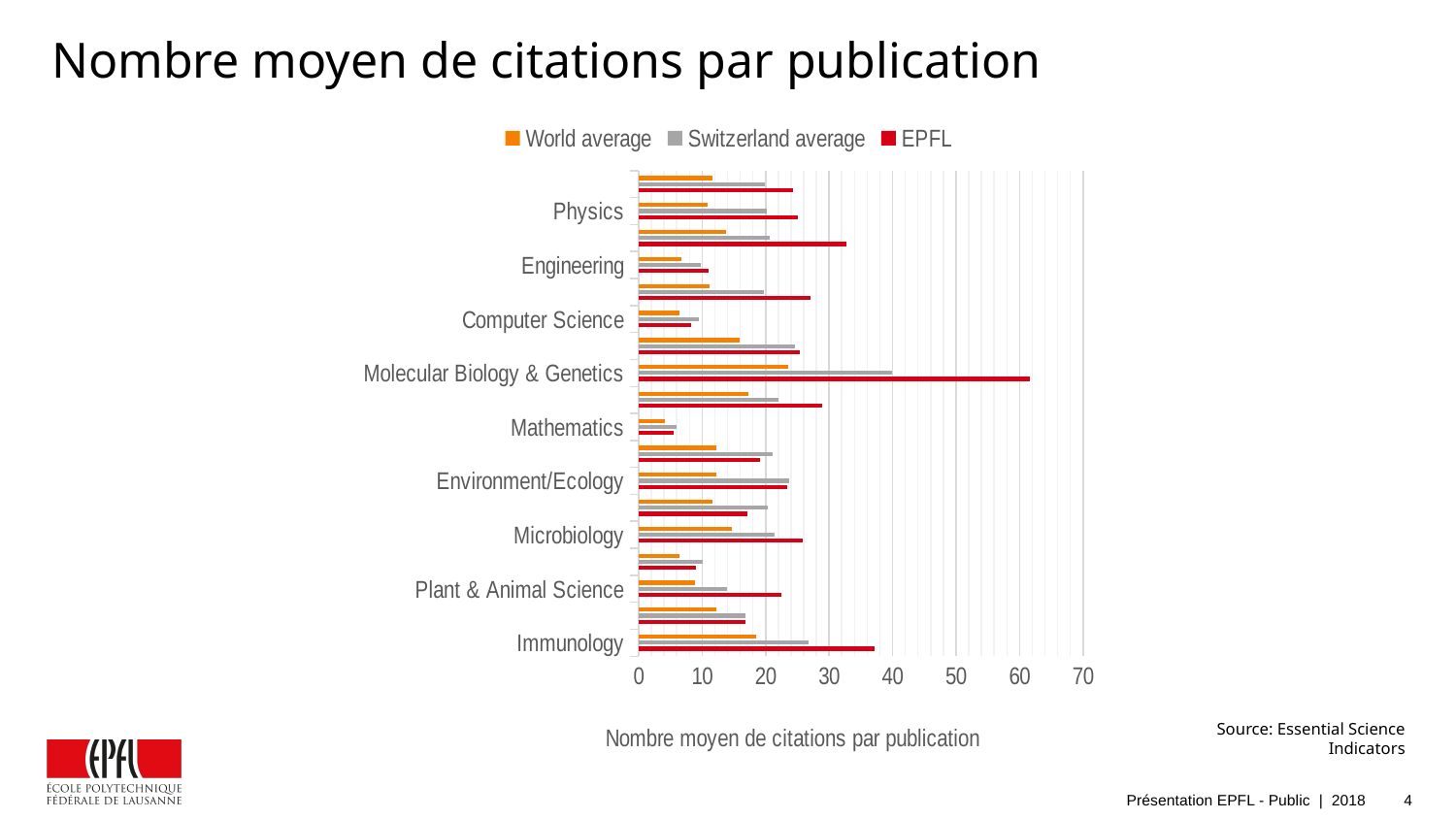
What kind of chart is shown on the slide? Bar chart For Immunology, which is larger: the EPFL value or the World average? EPFL What is the title of the chart? Nombre moyen de citations par publication Is the EPFL value for Immunology greater or less than 30? greater Which has the larger EPFL value: Physics or Engineering? Physics Is the Switzerland average for Molecular Biology & Genetics greater or less than 30? greater Is the EPFL value for Molecular Biology & Genetics greater or less than 50? greater Which labeled field has the highest EPFL value? Molecular Biology & Genetics How many series does the legend list? 3 What are the three series named in the legend? World average, Switzerland average, EPFL